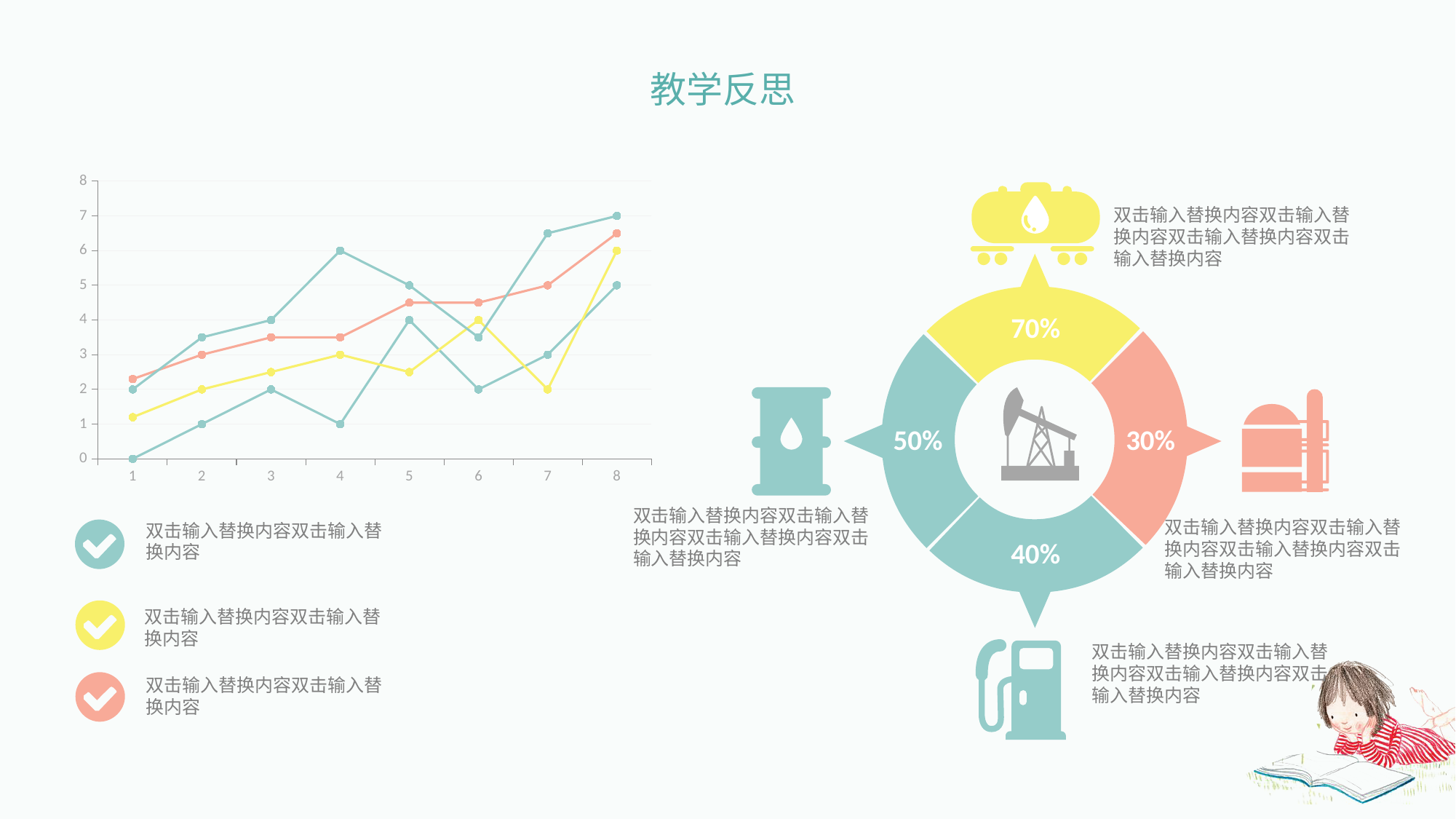
In the line chart, what is the value of the red line at x = 2? 3 How many lines are plotted in the line chart? 4 In the line chart, is the value of the yellow line at x = 1 greater or less than 2? less In the line chart, what is the value of the yellow line at x = 8? 6 What kind of chart is shown on the left of the slide? line chart How many points are on the x axis of the line chart? 8 In the line chart, what is the value of the yellow line at x = 4? 3 In the line chart, does the yellow line overall rise or fall from x = 1 to x = 8? rise In the line chart, what is the value of the red line at x = 7? 5 In the line chart, at x = 8, which is higher: the red line or the yellow line? red line What is the highest value reached by any line in the line chart? 7 In the line chart, is the value of the red line at x = 8 greater or less than 6? greater